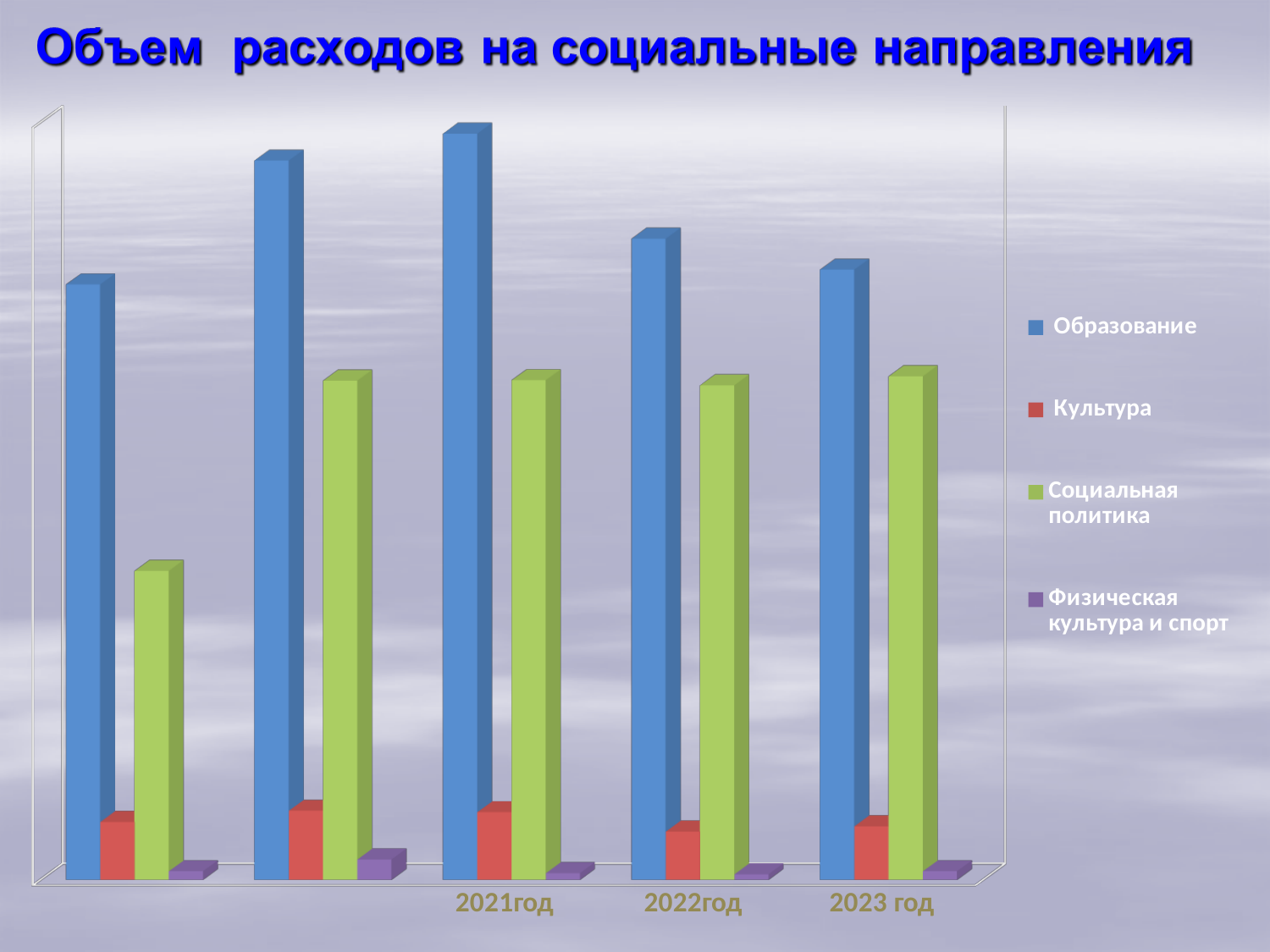
Which series is shown in green in the legend? Социальная политика Which series has the highest bar in the 2021год group? Образование Which series has the lowest bar in the 2023 год group? Физическая культура и спорт In the 2022год group, which is larger: Образование or Социальная политика? Образование What kind of chart is shown on the slide? bar chart Which of the labeled years has the tallest Образование bar? 2021год Does the Образование bar rise or fall from 2021год to 2023 год? fall What is the title of the chart? Объем расходов на социальные направления How many groups of bars are plotted on the chart? 5 How many series does the legend list? 4 In the 2023 год group, which is larger: Культура or Физическая культура и спорт? Культура